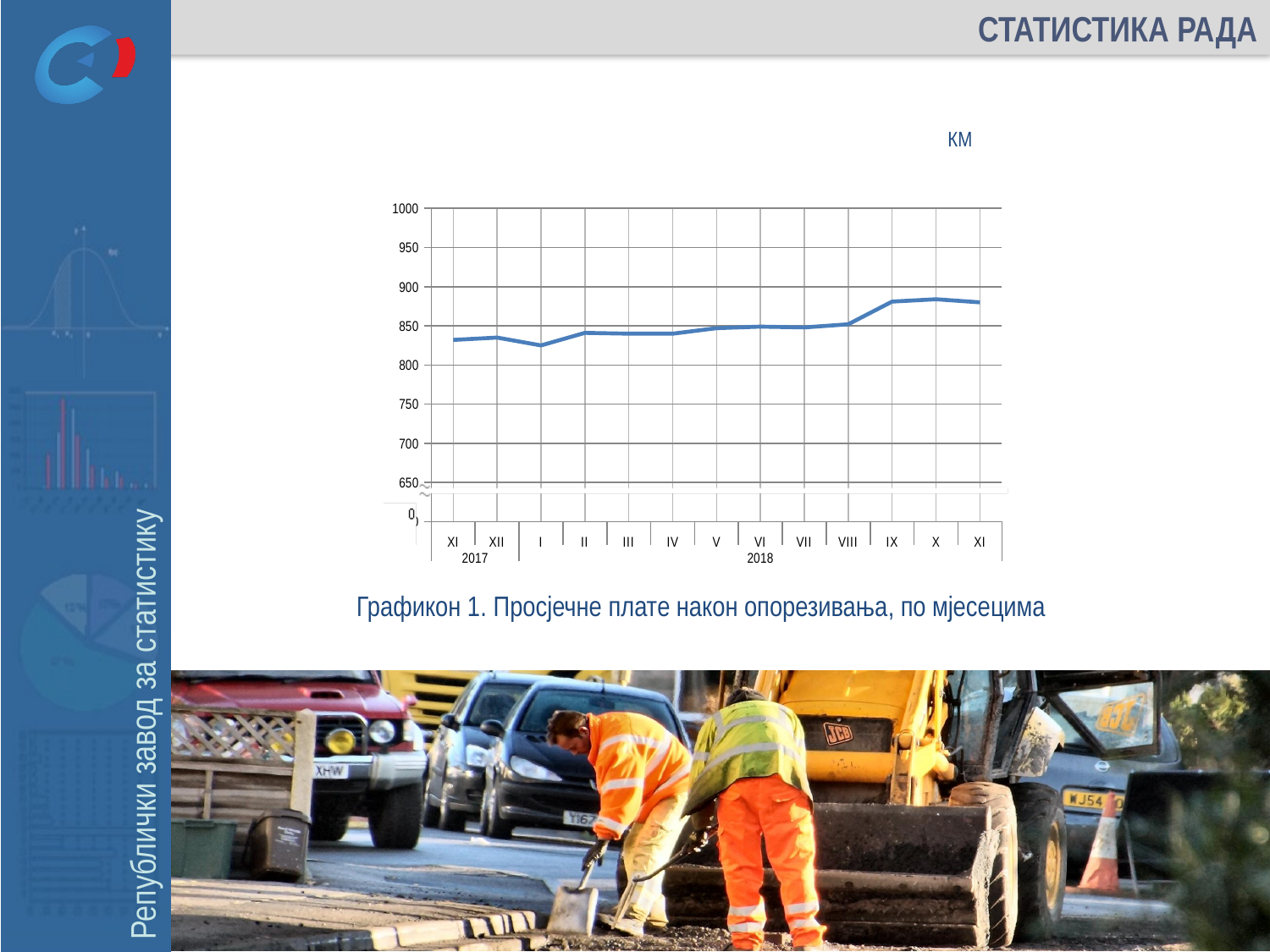
Is the value for IX 2018 greater or less than 900? less Is the value for X 2018 greater or less than 850? greater What unit is indicated above the chart? KM What kind of chart is shown on the slide? line chart Which month has the lowest value on the chart? I 2018 Is the value for XI 2017 greater or less than 800? greater Overall, do the values rise or fall from XI 2017 to XI 2018? rise Which is larger, the value for VIII 2018 or the value for IX 2018? IX 2018 Which is larger, the value for X 2018 or the value for I 2018? X 2018 What is the title of the chart? Графикон 1. Просјечне плате након опорезивања, по мјесецима How many monthly data points are plotted on the chart? 13